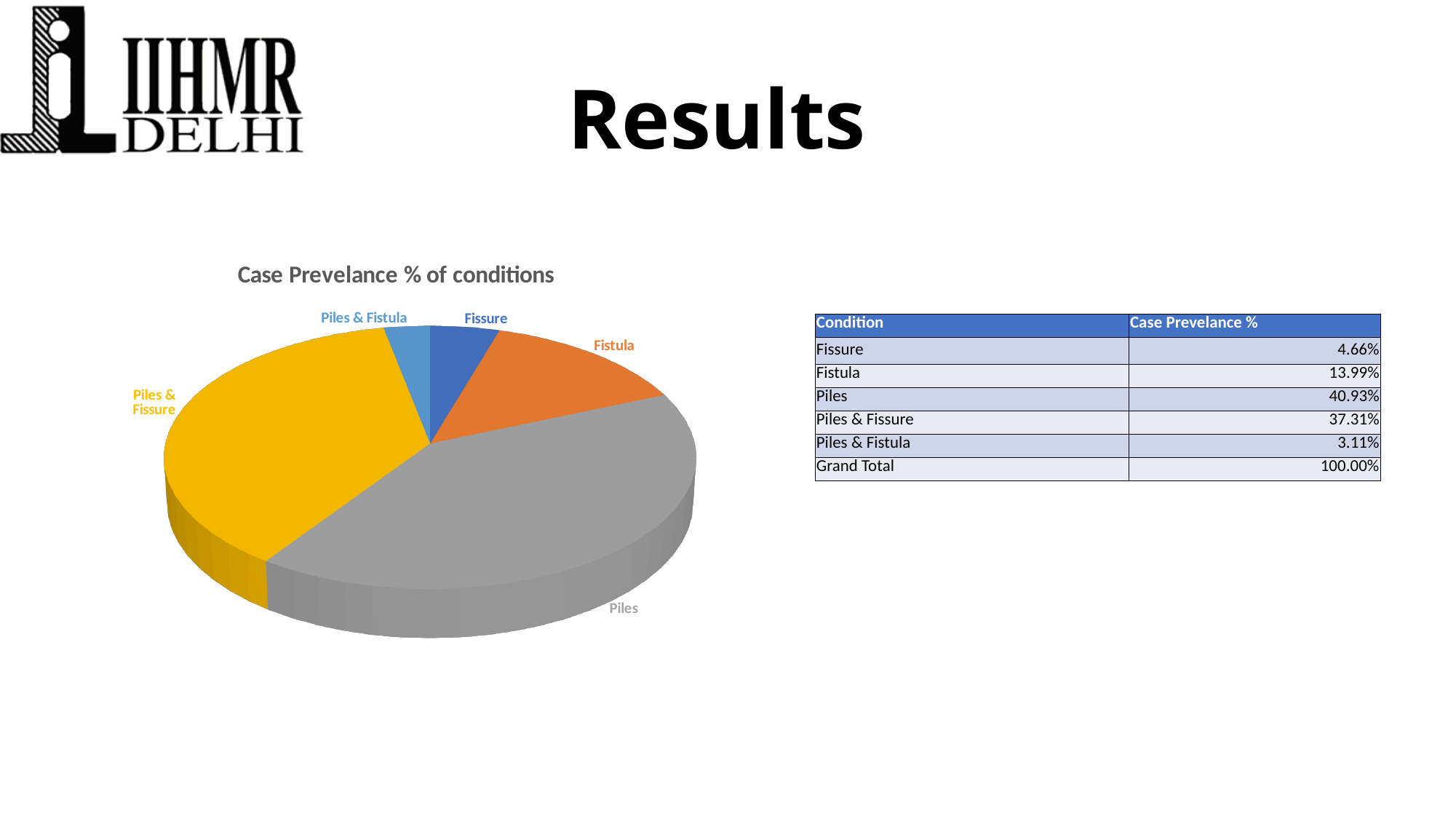
According to the slide, what is the case prevalence % for Piles? 40.93% Which slice is larger in the pie chart, Fistula or Fissure? Fistula Which condition has the largest slice in the "Case Prevelance % of conditions" pie chart? Piles What kind of chart is shown under the title "Case Prevelance % of conditions"? pie chart What is the title of the pie chart on the slide? Case Prevelance % of conditions What colour is the Piles slice in the pie chart? grey Which condition has the smallest slice in the "Case Prevelance % of conditions" pie chart? Piles & Fistula According to the slide, what is the case prevalence % for Fistula? 13.99% How many slices does the "Case Prevelance % of conditions" pie chart have? 5 What is the difference in case prevalence % between Piles and Piles & Fissure, as printed on the slide? 3.62% According to the slide, what is the case prevalence % for Piles & Fissure? 37.31% According to the slide, what is the case prevalence % for Fissure? 4.66%